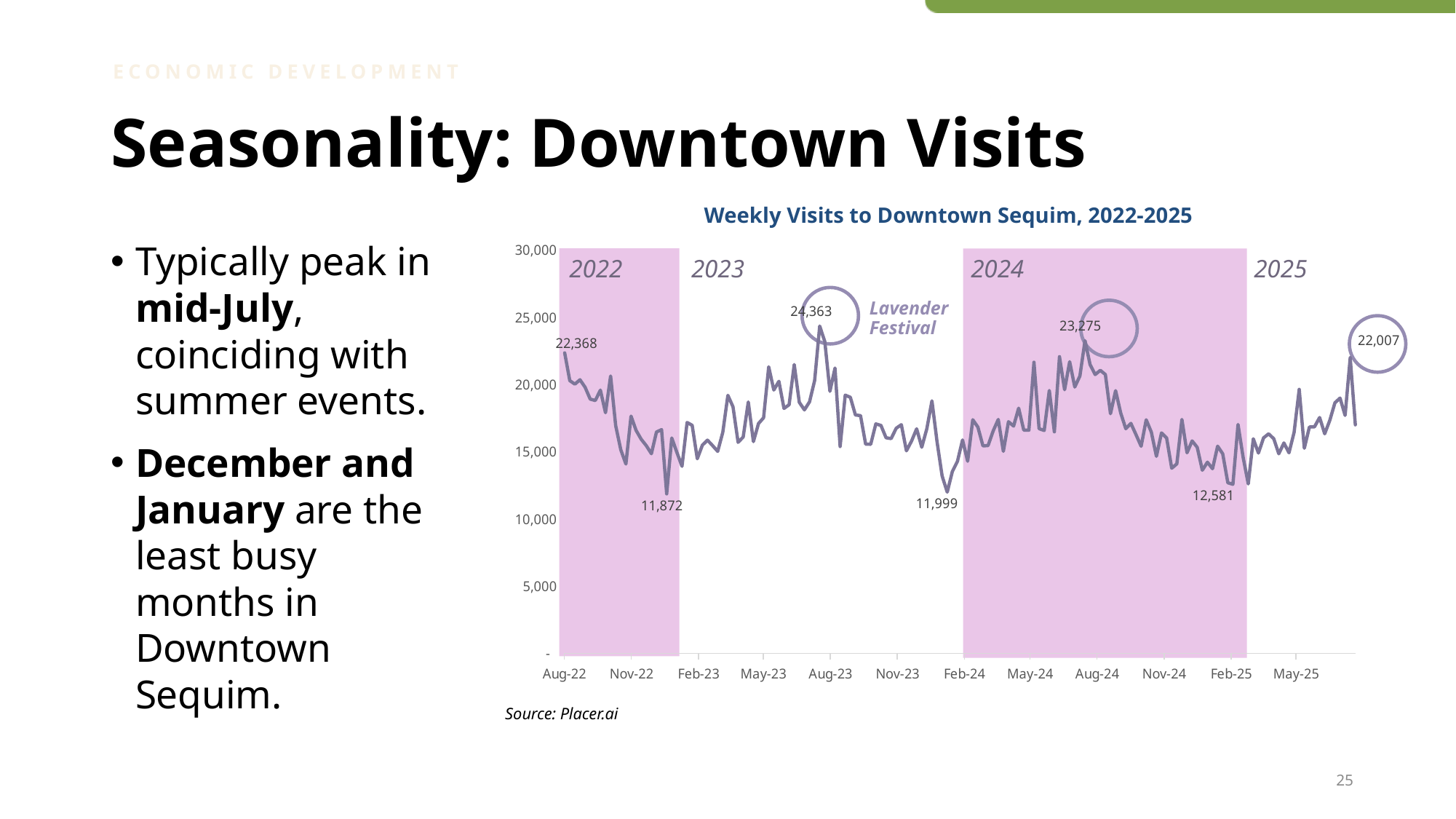
What is the labeled peak value of weekly visits in 2025? 22,007 What is the lowest labeled value on the chart? 11,872 What is the highest labeled value on the chart? 24,363 What is the labeled peak value of weekly visits in 2023? 24,363 Which event is annotated next to the 2023 peak on the chart? Lavender Festival What is the labeled value at the start of the series in Aug-22? 22,368 Which is larger, the 2024 peak or the 2025 peak? The 2024 peak (23,275) What is the labeled peak value of weekly visits in 2024? 23,275 What is the title of the chart? Weekly Visits to Downtown Sequim, 2022-2025 What kind of chart is shown on the slide? Line chart Do the labeled annual peaks rise or fall from 2023 to 2025? Fall What is the difference between the 2023 peak (24,363) and the 2024 peak (23,275)? 1,088